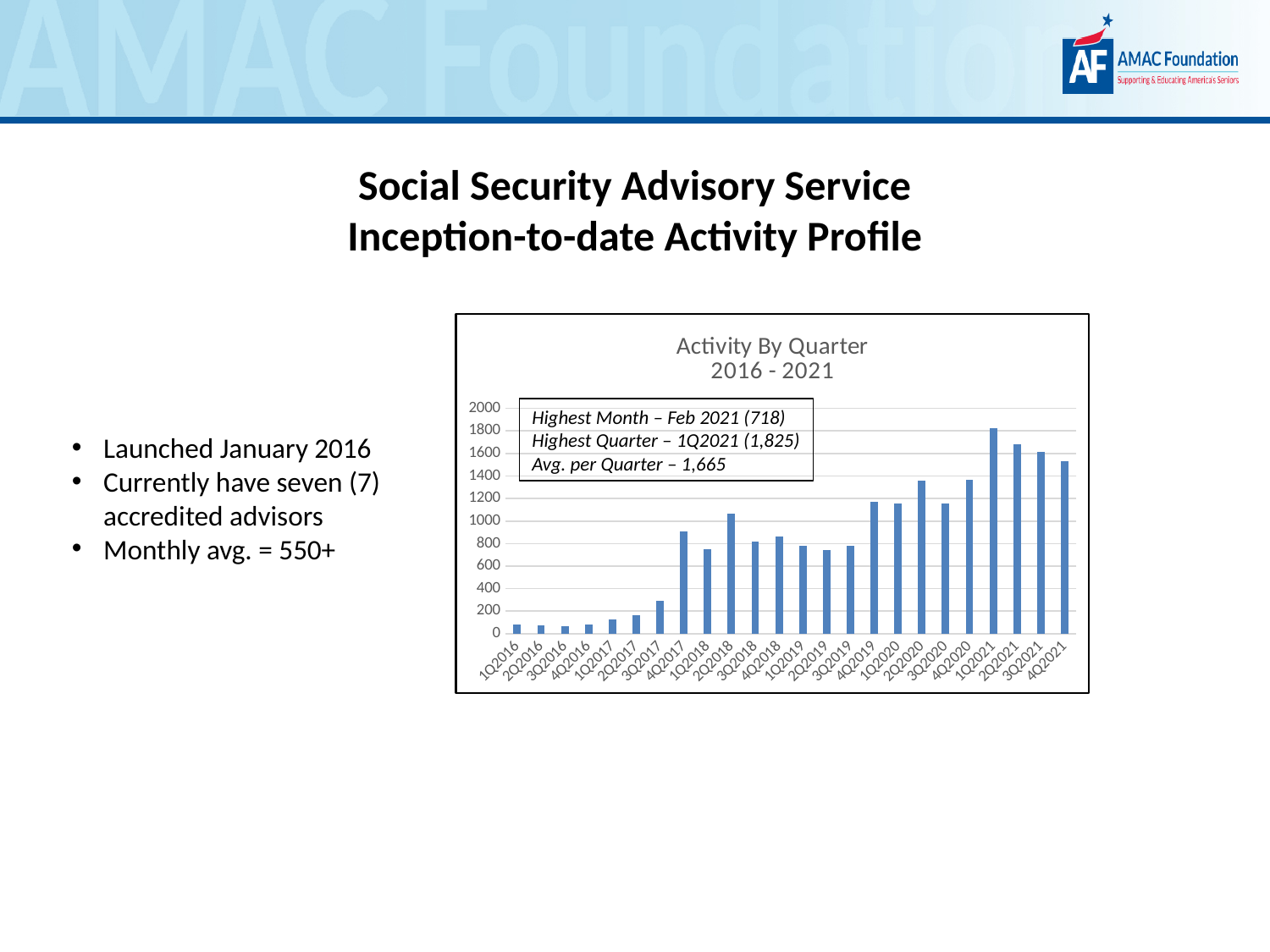
Which is larger, the value for 4Q2017 or the value for 1Q2018? 4Q2017 Is the value for 4Q2021 greater or less than 1600? less Is the value for 1Q2018 greater or less than 800? less Which quarter has the highest bar in the chart? 1Q2021 How many quarters are plotted on the x axis of the chart? 24 Is the value for 2Q2018 greater or less than 1000? greater What kind of chart is shown on the slide? bar chart Overall, do the values rise or fall from 1Q2016 to 1Q2021? rise According to the annotation on the chart, what was the activity value for the highest quarter, 1Q2021? 1,825 What is the title of the chart? Activity By Quarter 2016 - 2021